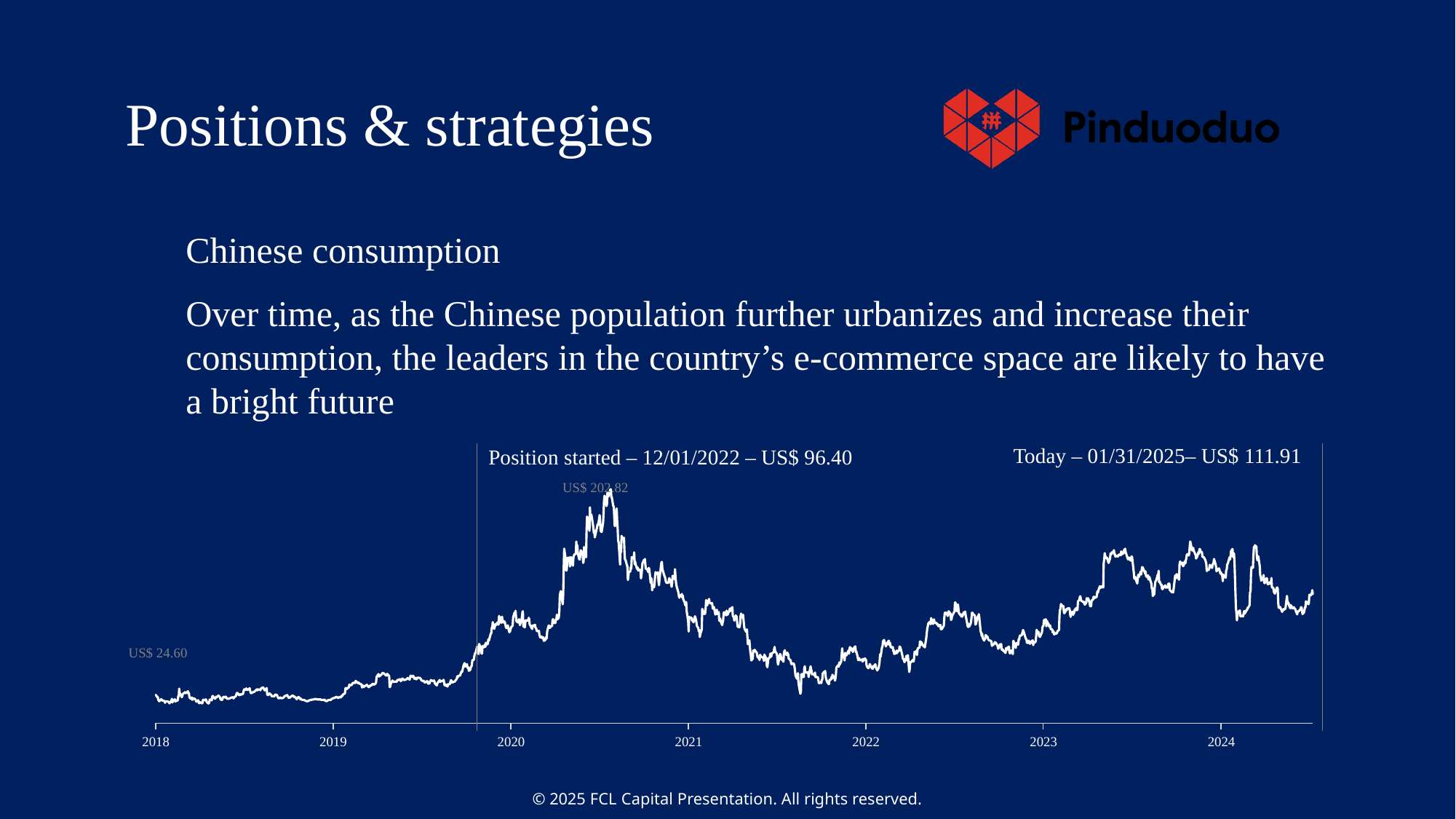
Does the price line rise or fall between 2018 and its peak in 2020? rise What is the difference between the 'Today' price and the price when the position was started? US$ 15.51 What kind of chart is shown on the slide? line chart How many year labels are shown on the x axis? 7 In which year does the price line reach its highest point? 2020 What is the share price labelled as 'Today' on the chart? US$ 111.91 On what date was the position started, according to the chart annotation? 12/01/2022 What date is given for 'Today' on the chart? 01/31/2025 Which is higher: the price when the position was started or the 'Today' price? Today (US$ 111.91) What was the Pinduoduo share price when the position was started? US$ 96.40 What is the difference between the price when the position was started (US$ 96.40) and the starting value labelled on the left (US$ 24.60)? US$ 71.80 What value is labelled at the left (start) of the price line? US$ 24.60